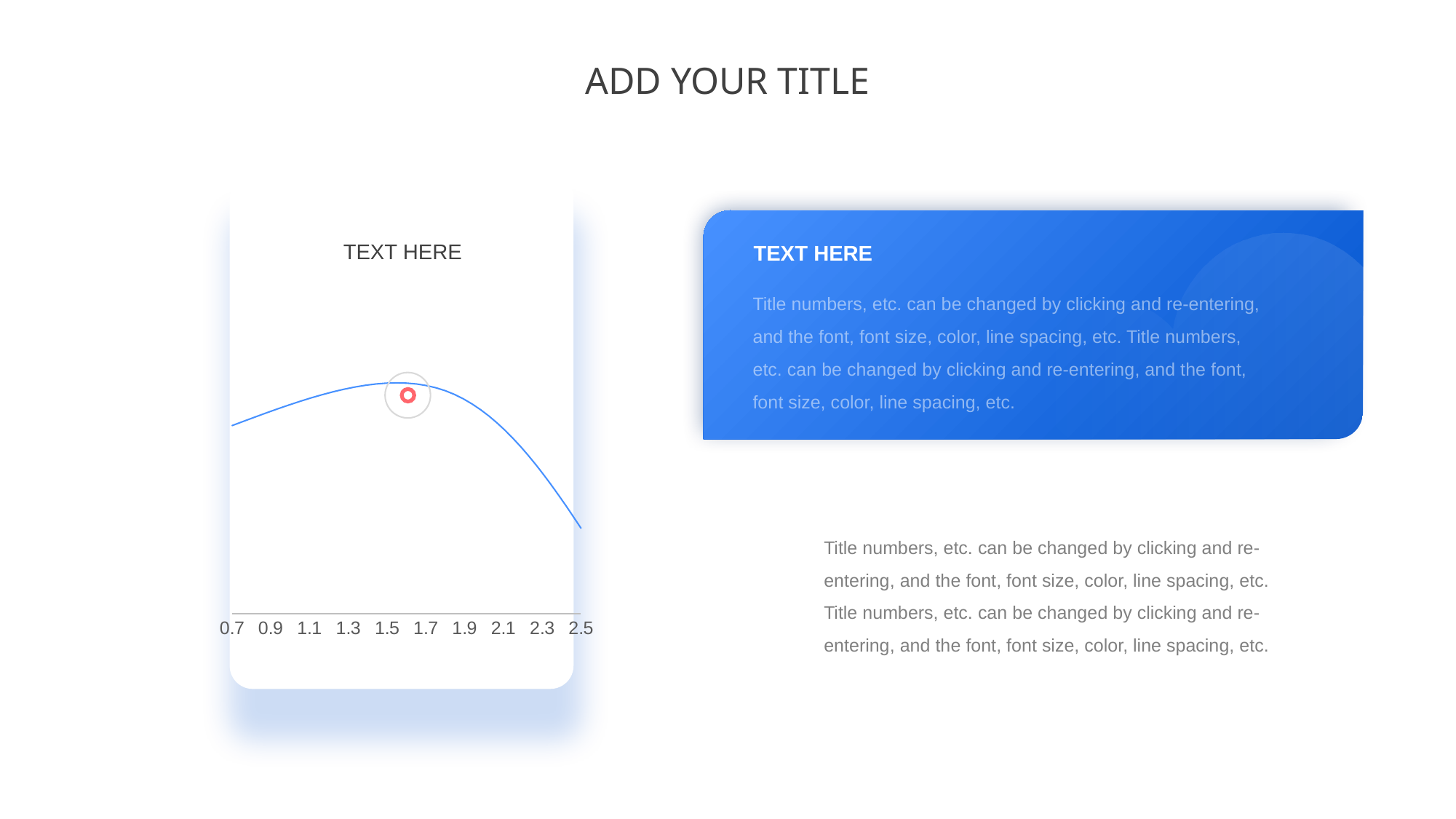
At which x-axis tick is the line at its lowest? 2.5 How many tick labels are shown on the x axis of the chart? 10 What kind of chart is shown on the slide? line chart Does the line rise or fall between 1.9 and 2.5 on the x axis? fall What is the last tick label on the x axis of the chart? 2.5 Does the line rise or fall between 0.7 and 1.5 on the x axis? rise Is the line higher at 1.5 or at 2.3 on the x axis? 1.5 How many lines are plotted on the chart? 1 What is the first tick label on the x axis of the chart? 0.7 Is the line higher at 0.7 or at 2.5 on the x axis? 0.7 Does the line reach its highest point at the left end, the right end, or in the middle of the x axis? in the middle